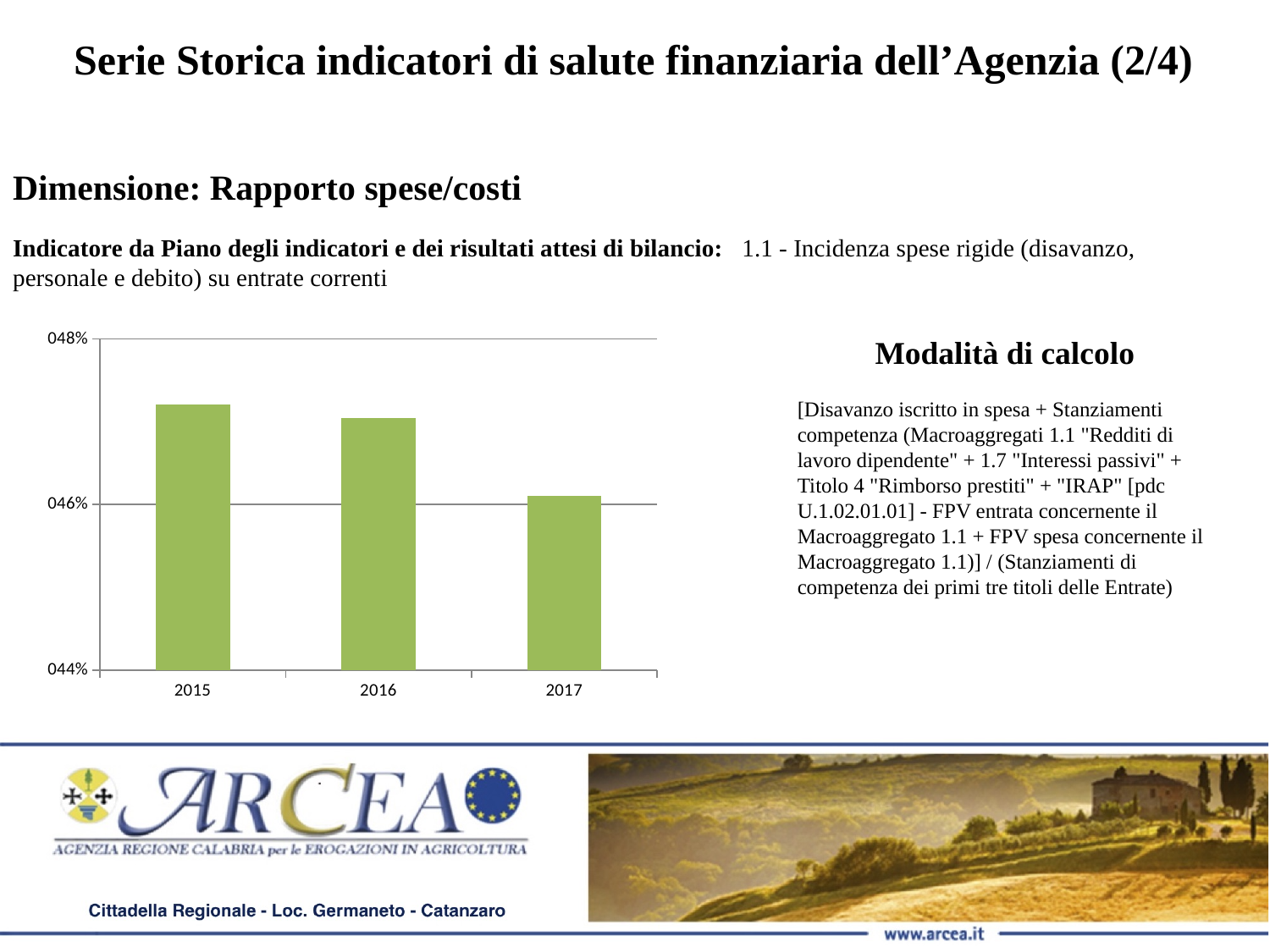
What colour are the bars in the chart? green Which is larger, the value for 2016 or the value for 2017? 2016 How many years are shown on the x axis of the chart? 3 What kind of chart is shown on the slide? bar chart Is the value for 2015 greater or less than 046%? greater Is the value for 2017 greater or less than 048%? less Do the values rise or fall from 2015 to 2017? fall Which is larger, the value for 2015 or the value for 2017? 2015 Is the value for 2015 greater or less than 048%? less Which year has the lowest value in the chart? 2017 What is the lowest tick label shown on the y axis of the chart? 044%